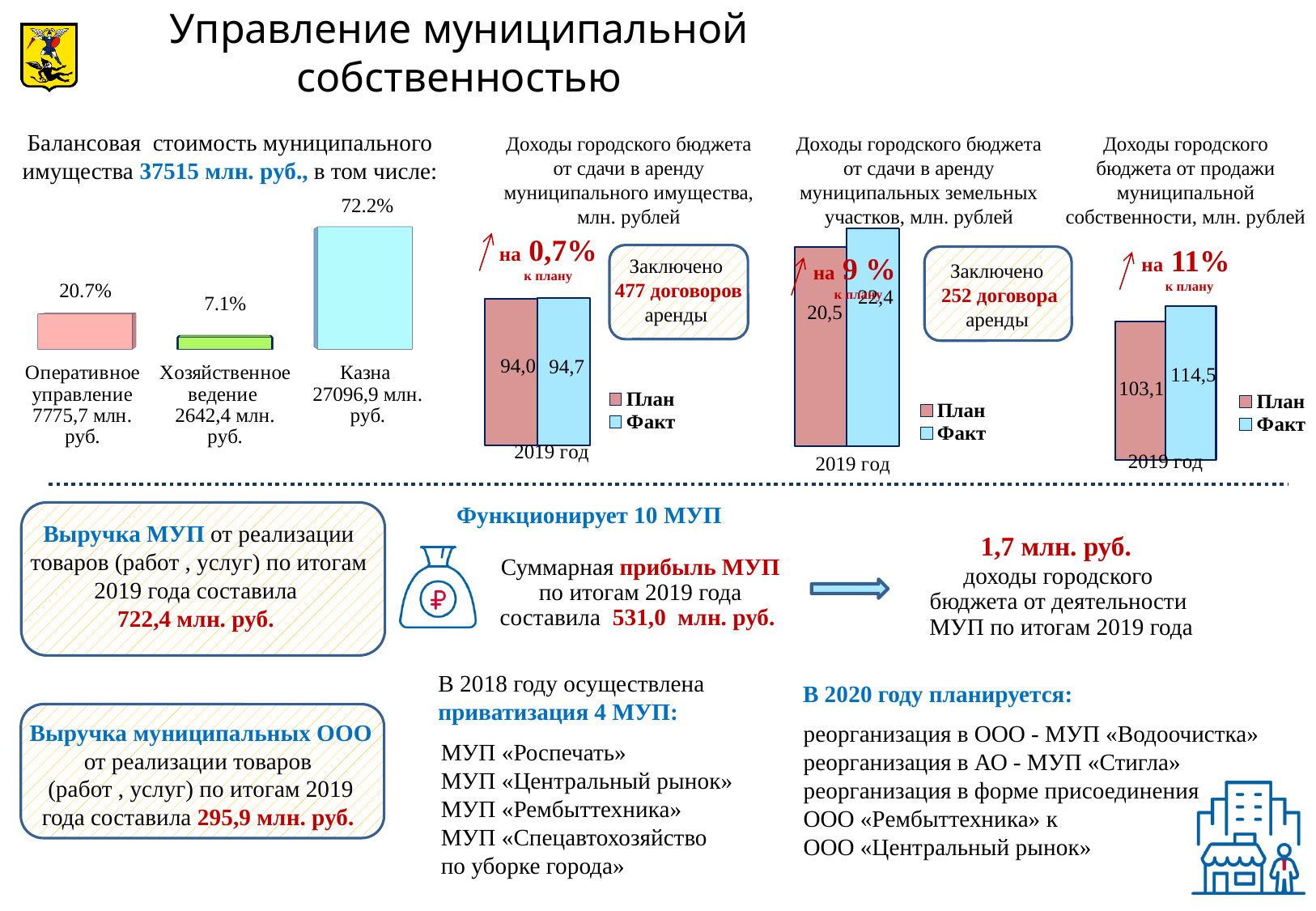
On the chart of the balance value of municipal property (left), which category has the lowest share? Хозяйственное ведение On the chart of the balance value of municipal property (left), how many bars are shown? 3 On the chart of the balance value of municipal property (left), what is the difference between the shares of Казна and Оперативное управление? 51.5% On the chart of the balance value of municipal property (left), which category has the highest share? Казна On the chart 'Доходы городского бюджета от продажи муниципальной собственности', how many series does the legend list? 2 On the chart of the balance value of municipal property (left), what percentage is shown for Казна? 72.2% On the chart 'Доходы городского бюджета от продажи муниципальной собственности', which is larger, План or Факт? Факт On the chart of the balance value of municipal property (left), what percentage is shown for Хозяйственное ведение? 7.1% On the chart 'Доходы городского бюджета от сдачи в аренду муниципального имущества', what is the value for План? 94,0 On the chart 'Доходы городского бюджета от продажи муниципальной собственности', what is the value for Факт? 114,5 On the chart 'Доходы городского бюджета от сдачи в аренду муниципального имущества', what is the value for Факт? 94,7 On the chart 'Доходы городского бюджета от сдачи в аренду муниципальных земельных участков', what is the difference between Факт and План? 1,9